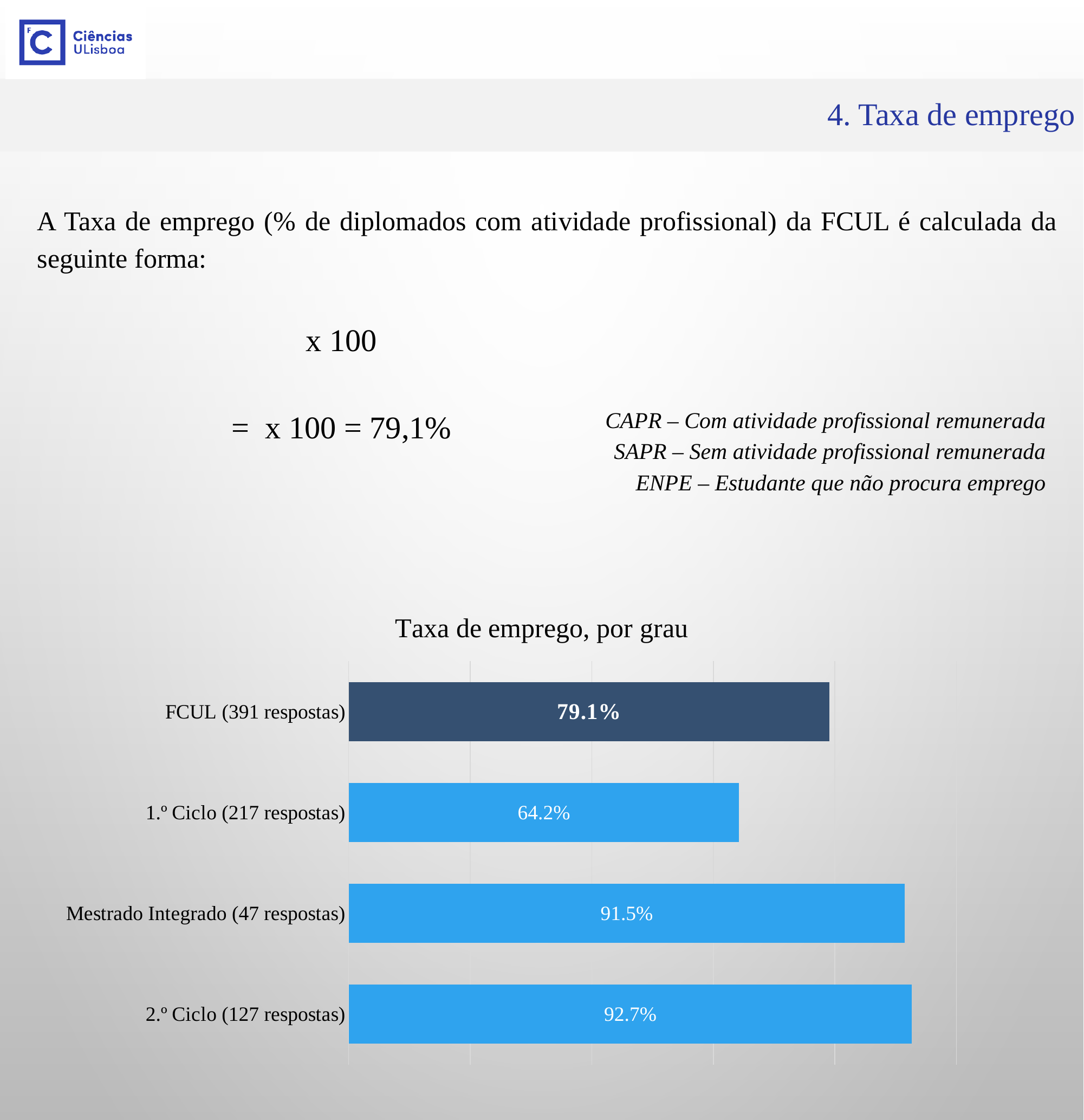
What is the employment rate shown for 2.º Ciclo (127 respostas)? 92.7% What is the title of the chart on the slide? Taxa de emprego, por grau Which has a higher employment rate, 1.º Ciclo or Mestrado Integrado? Mestrado Integrado What is the difference between the employment rates of 2.º Ciclo and 1.º Ciclo? 28.5% What is the employment rate shown for 1.º Ciclo (217 respostas)? 64.2% Which category has the lowest employment rate in the chart? 1.º Ciclo (217 respostas) What is the employment rate shown for Mestrado Integrado (47 respostas)? 91.5% How many categories are shown in the chart? 4 What is the employment rate shown for FCUL (391 respostas)? 79.1% What is the difference between the employment rates of Mestrado Integrado and FCUL? 12.4% What kind of chart is shown on the slide? Bar chart Which category has the highest employment rate in the chart? 2.º Ciclo (127 respostas)